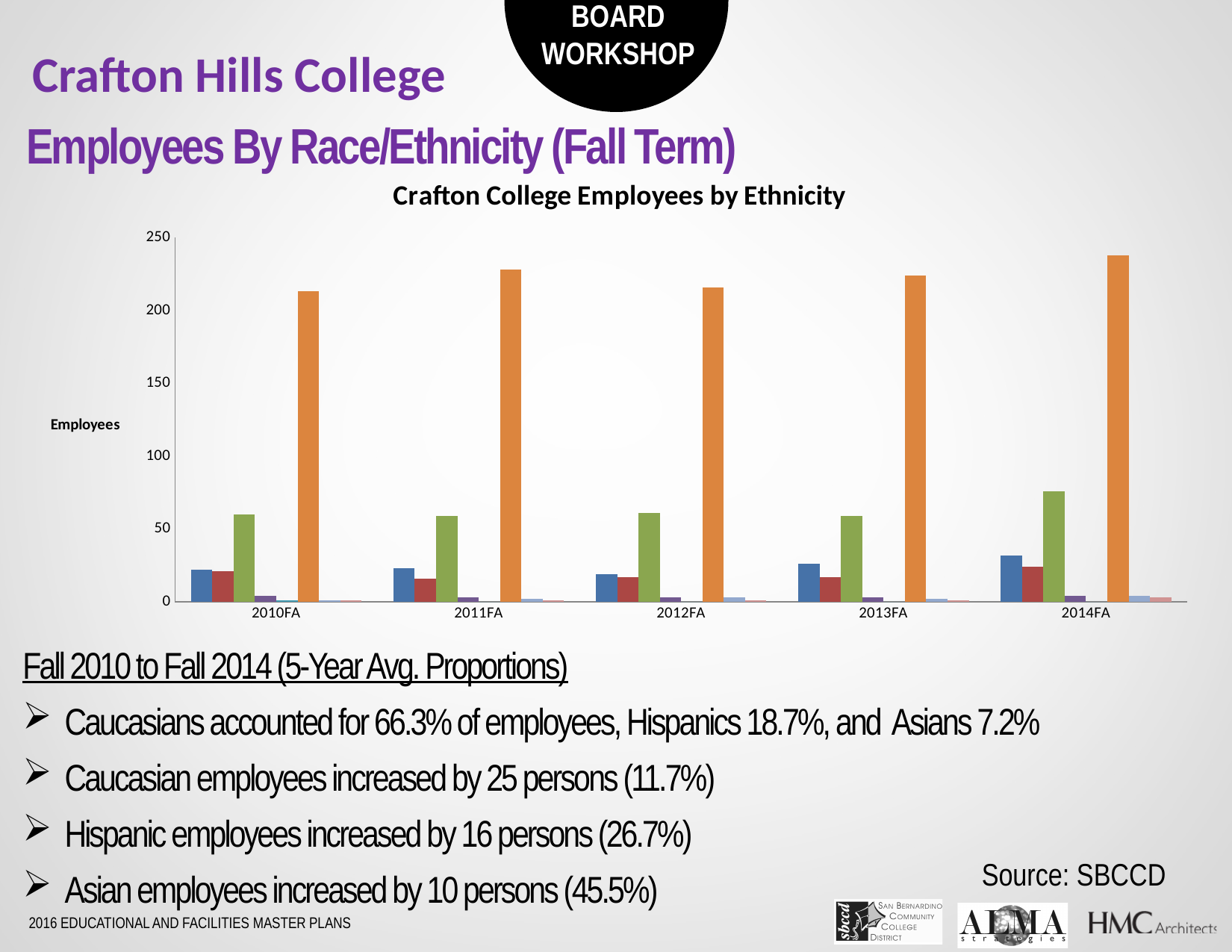
Is the value of the orange bar for 2010FA greater or less than 200? greater What is the label on the vertical axis of the chart? Employees Is the value of the orange bar for 2012FA greater or less than 250? less What is the title of the chart? Crafton College Employees by Ethnicity What kind of chart is shown on the slide? Bar chart In which fall term is the tallest orange bar the highest? 2014FA Is the value of the green bar for 2014FA greater or less than 50? greater Which is larger, the blue bar for 2014FA or the blue bar for 2010FA? 2014FA How many fall terms (categories) are shown on the x axis of the chart? 5 Which is larger, the green bar for 2014FA or the green bar for 2013FA? 2014FA